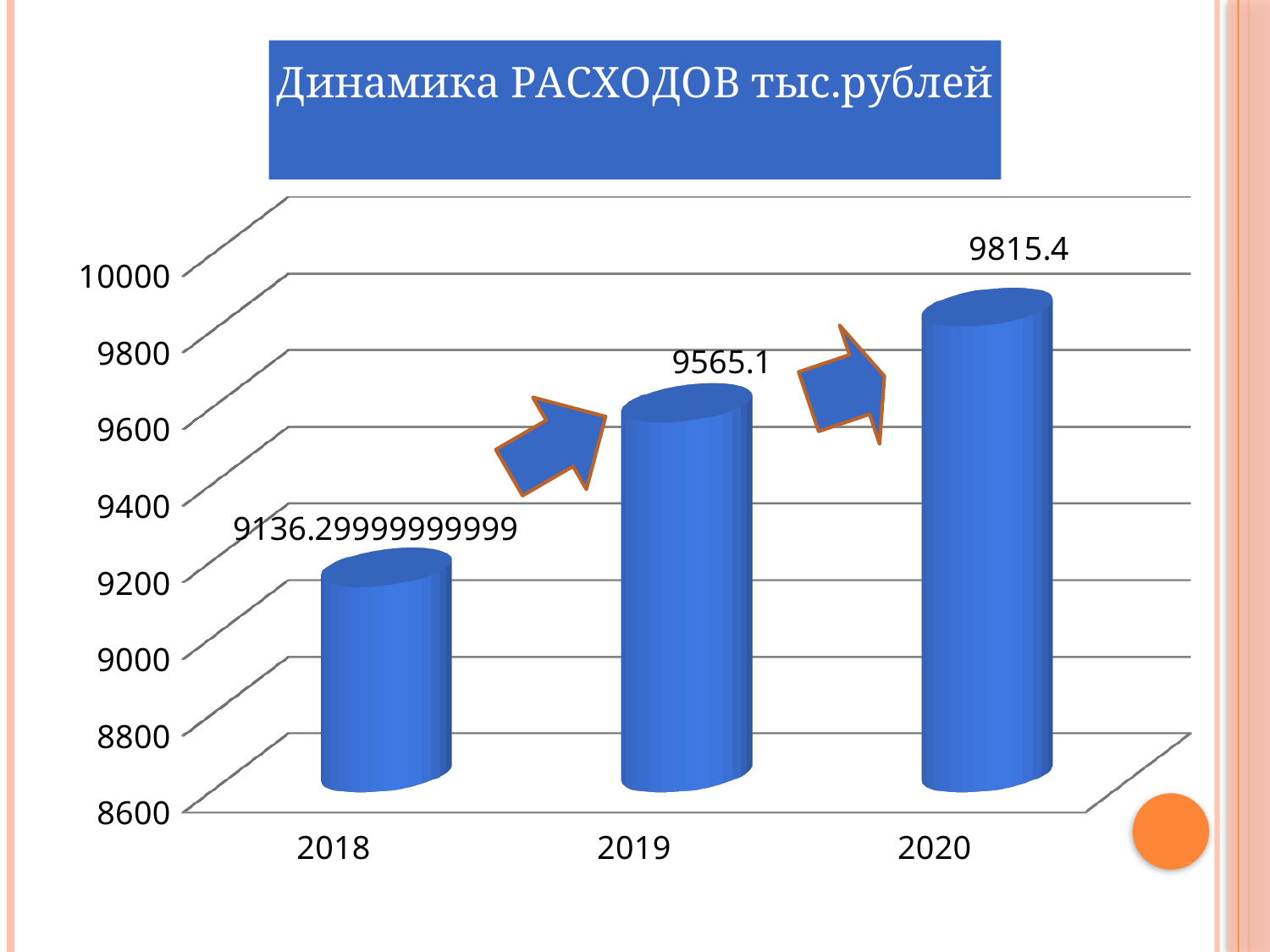
How many years are shown on the x axis? 3 Do the values rise or fall from 2018 to 2020? rise Is the value for 2020 greater or less than 9800? greater What is the difference between the values for 2020 and 2019? 250.3 What is the value for 2020? 9815.4 Which year has the lowest value? 2018 What is the value for 2019? 9565.1 Which year has the highest value? 2020 Is the value for 2018 greater or less than 9200? less What is the value shown for 2018? 9136.29999999999 What kind of chart is shown on the slide? bar chart Which is larger, the value for 2019 or the value for 2020? 2020